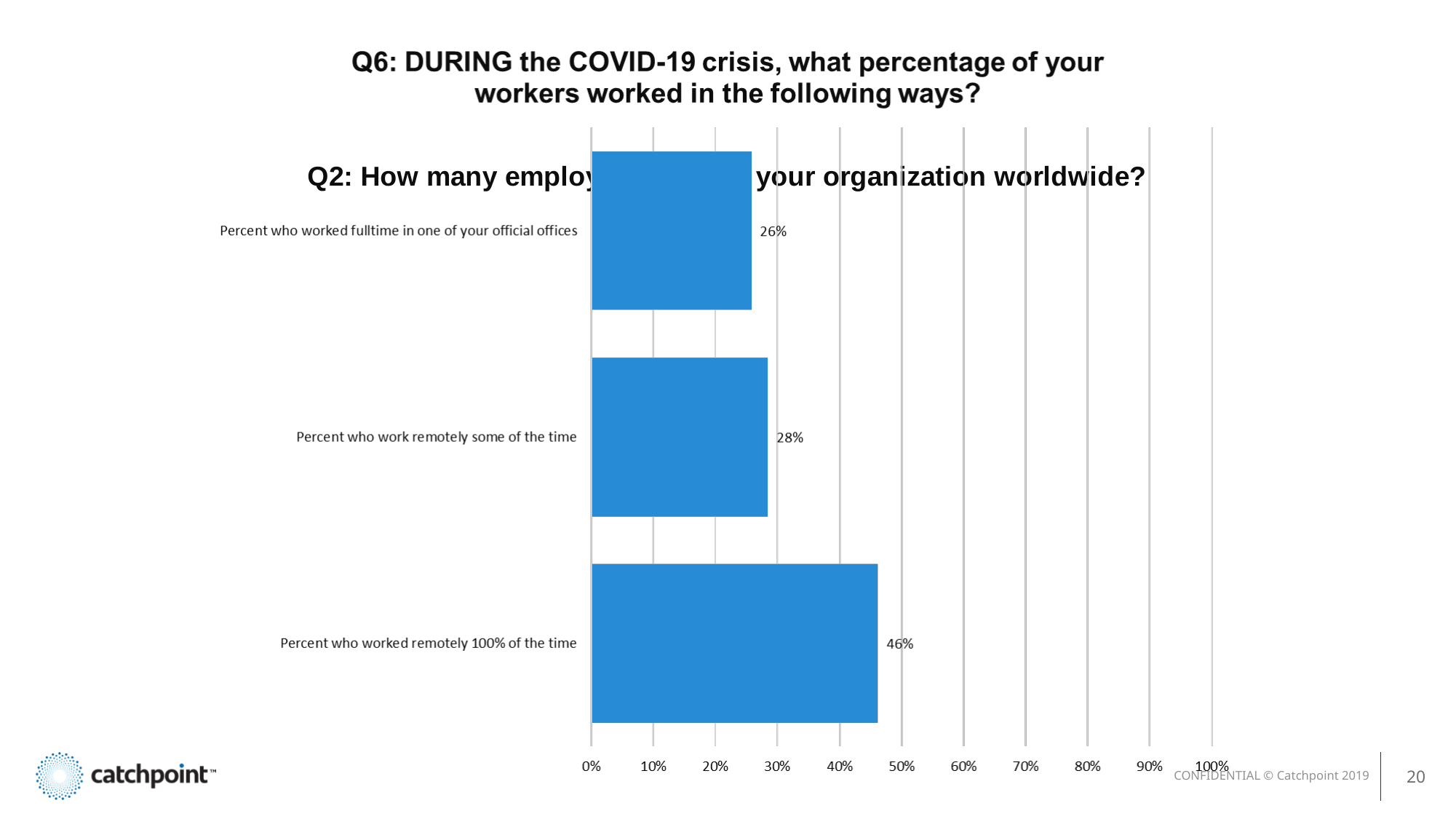
What is the difference between the percentage who worked remotely 100% of the time and the percentage who worked fulltime in an official office? 20% Which category has the highest value? Percent who worked remotely 100% of the time What is the highest value shown on the horizontal axis? 100% Which category has the lowest value? Percent who worked fulltime in one of your official offices What percentage of workers worked remotely 100% of the time? 46% What percentage of workers work remotely some of the time? 28% How many categories are shown in the chart? 3 What is the difference between the percentage who work remotely some of the time and the percentage who worked fulltime in an official office? 2% What kind of chart is shown on the slide? Bar chart What percentage of workers worked fulltime in one of the official offices? 26% Is the value for workers who worked remotely 100% of the time greater or less than 50%? less Which is larger: the percentage who worked remotely 100% of the time or the percentage who work remotely some of the time? Percent who worked remotely 100% of the time